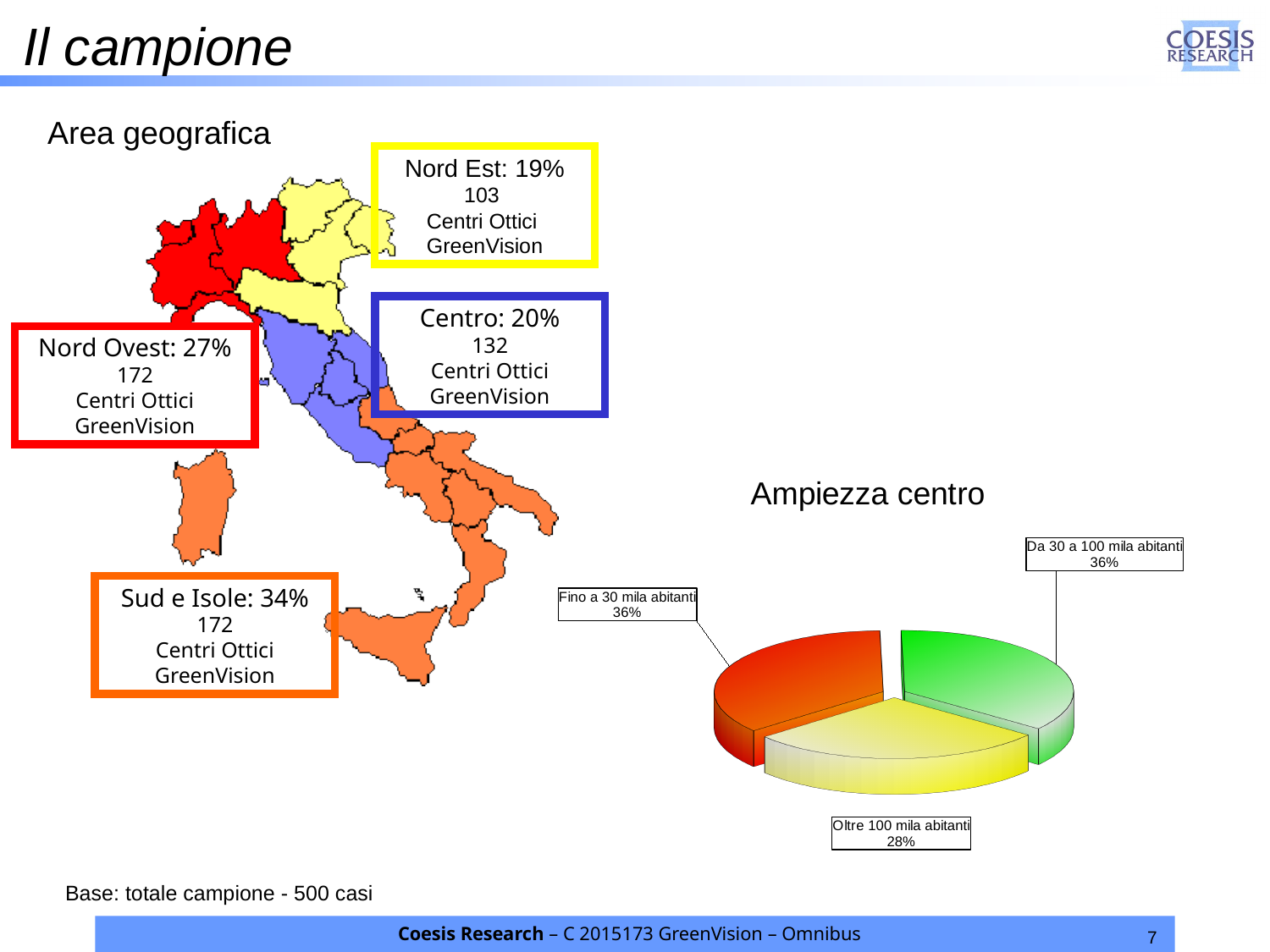
In the 'Ampiezza centro' pie chart, what colour is the 'Oltre 100 mila abitanti' slice? yellow On the 'Area geografica' map, how many Centri Ottici GreenVision are shown for 'Centro'? 132 In the 'Ampiezza centro' pie chart, what share is shown for 'Fino a 30 mila abitanti'? 36% In the 'Ampiezza centro' pie chart, what is the difference in percentage points between 'Da 30 a 100 mila abitanti' and 'Oltre 100 mila abitanti'? 8 percentage points In the 'Ampiezza centro' pie chart, what share is shown for 'Oltre 100 mila abitanti'? 28% What kind of chart is the 'Ampiezza centro' chart? pie chart In the 'Ampiezza centro' pie chart, what share is shown for 'Da 30 a 100 mila abitanti'? 36% On the 'Area geografica' map, what percentage is shown for 'Sud e Isole'? 34% In the 'Ampiezza centro' pie chart, which category has the smallest share? Oltre 100 mila abitanti How many slices does the 'Ampiezza centro' pie chart have? 3 In the 'Ampiezza centro' pie chart, which is larger: 'Fino a 30 mila abitanti' or 'Oltre 100 mila abitanti'? Fino a 30 mila abitanti What is the title of the pie chart on the slide? Ampiezza centro